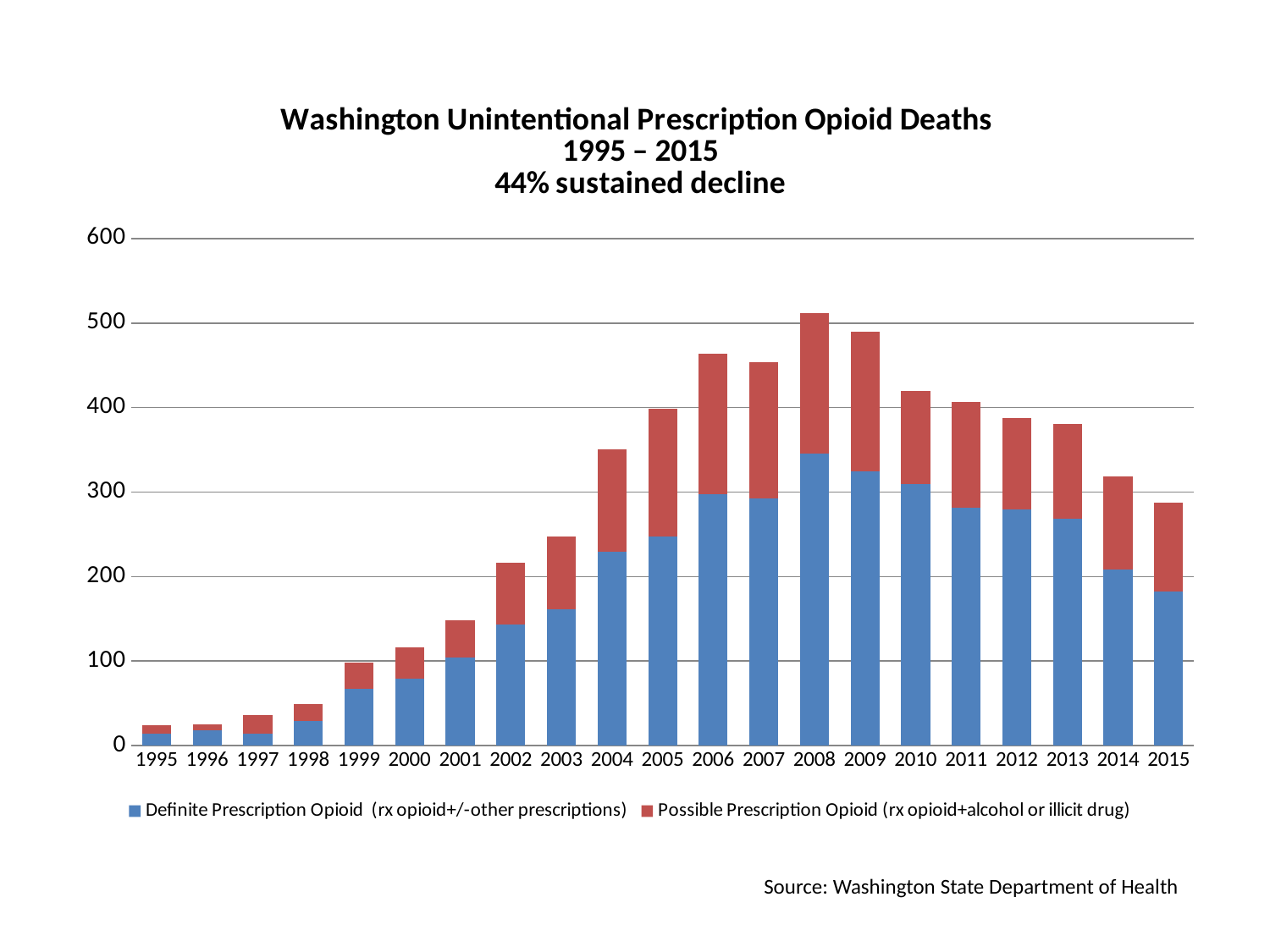
Is the total value for 2004 greater or less than 300? greater Which year has the highest total number of deaths? 2008 Is the total value for 2008 greater or less than 400? greater What source is cited for the chart data? Washington State Department of Health Which year has the larger total, 2014 or 2015? 2014 Is the total value for 2015 greater or less than 300? less How many years are shown along the x axis? 21 Do the total deaths rise or fall from 2008 to 2015? fall How many series does the legend list? 2 Which colour represents the Definite Prescription Opioid series? Blue What kind of chart is shown on the slide? Stacked bar chart